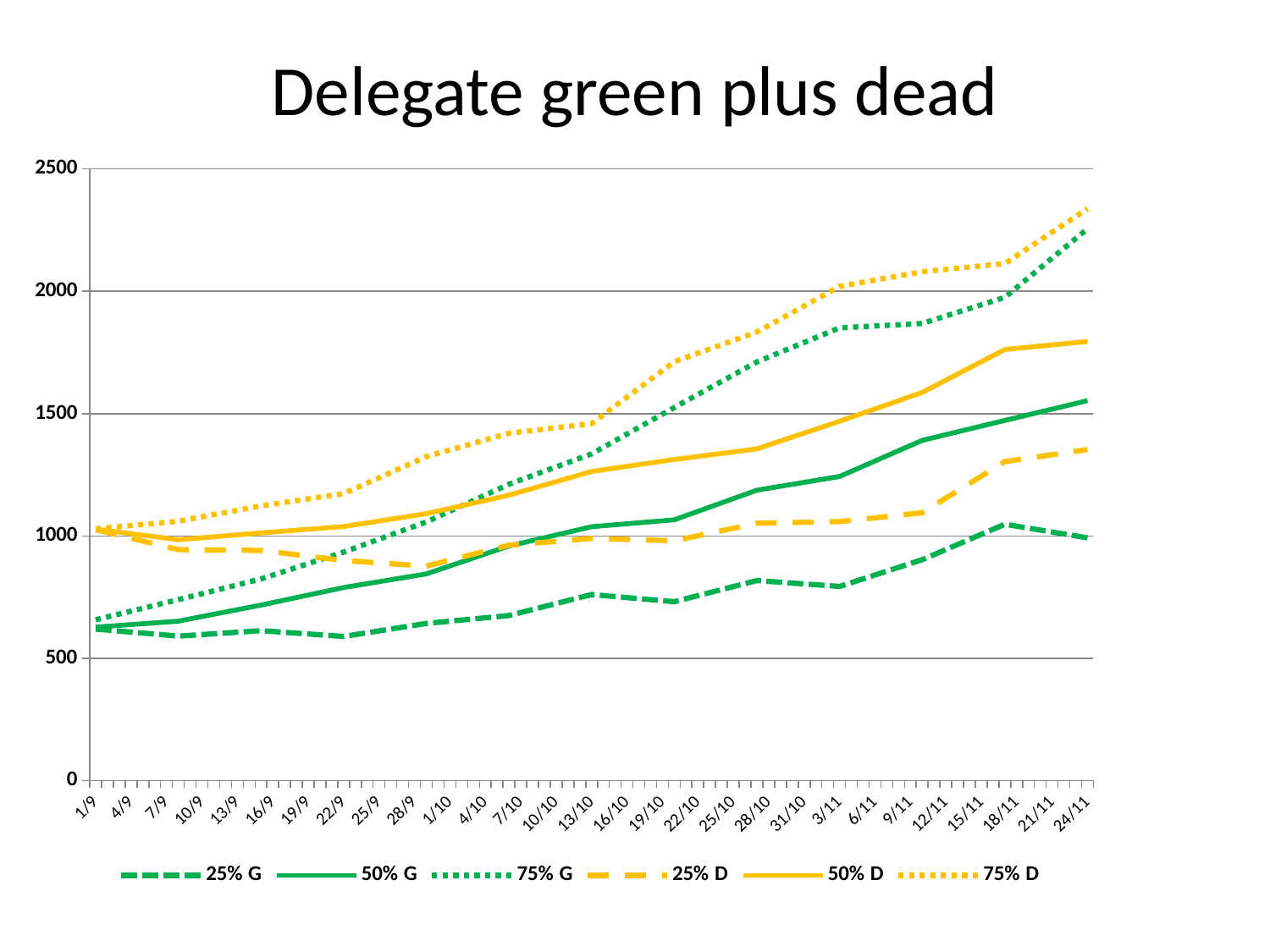
How many dates are labelled along the x axis? 29 Is the value for 50% D at 24/11 greater or less than 1500? greater Does the 75% D series generally rise or fall from 1/9 to 24/11? Rise At 24/11, which is larger: 50% D or 50% G? 50% D What is the title of the chart? Delegate green plus dead What kind of chart is shown on the slide? Line chart Is the value for 75% D at 24/11 greater or less than 2000? greater How many series does the legend list? 6 Is the value for 75% G at 1/9 greater or less than 1000? less Which series has the lowest value at 24/11? 25% G